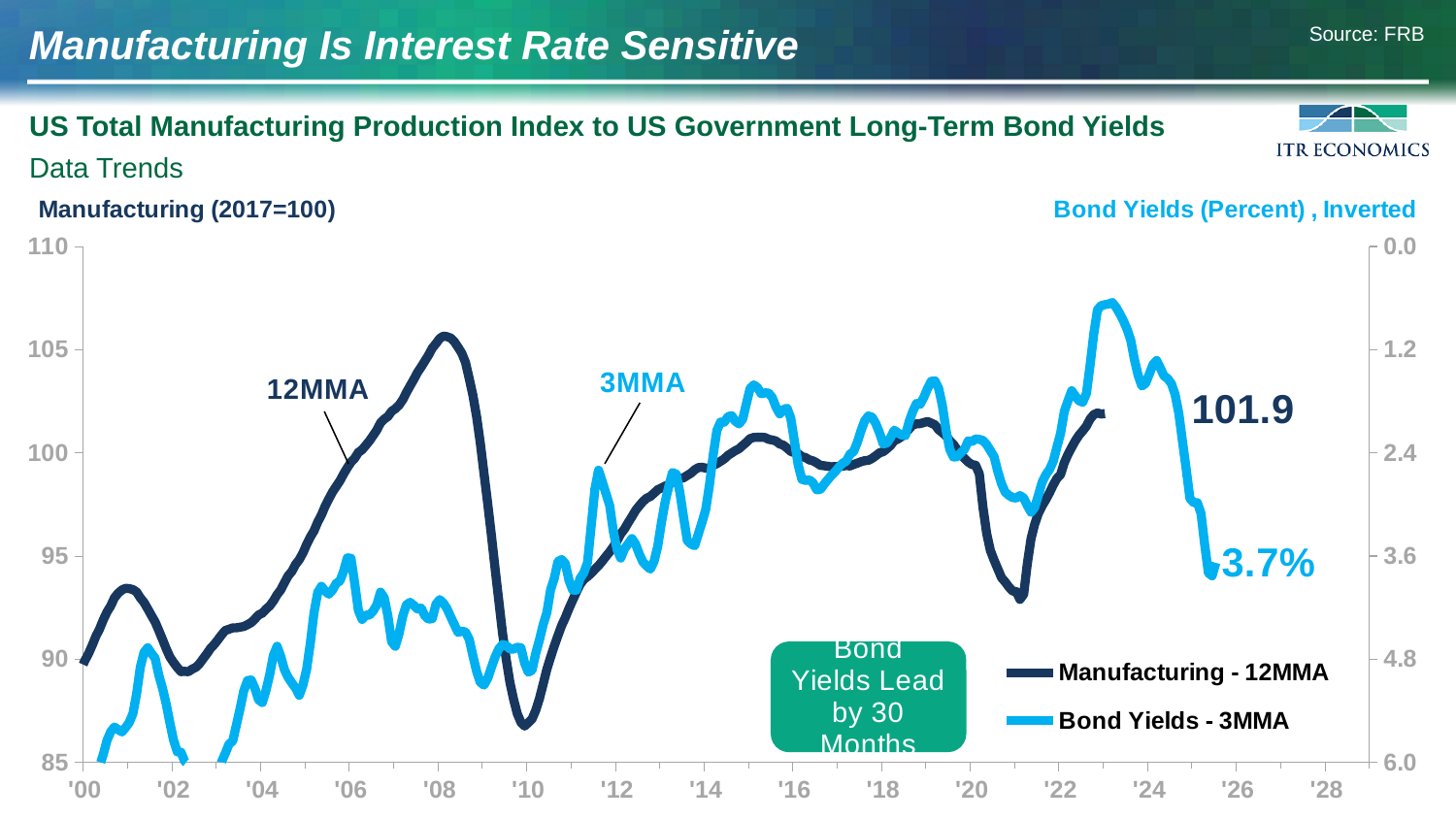
How many year labels are shown on the x axis? 15 Is the Manufacturing - 12MMA series higher at its 2008 peak or at its 2010 trough? 2008 peak What does the green callout box on the chart say? Bond Yields Lead by 30 Months What is the title of the chart? US Total Manufacturing Production Index to US Government Long-Term Bond Yields What type of chart is shown on the slide? line chart How many series does the legend list? 2 What is the latest labeled value of the Manufacturing - 12MMA series? 101.9 Does the Manufacturing - 12MMA series rise or fall between 2021 and 2023? rise Is the value of the Manufacturing - 12MMA series at its peak around 2008 greater or less than 100? greater Is the value of the Manufacturing - 12MMA series at the start of 2000 greater or less than 95? less What is the latest labeled value of the Bond Yields - 3MMA series? 3.7% Is the value of the Manufacturing - 12MMA series at its trough around 2010 greater or less than 90? less